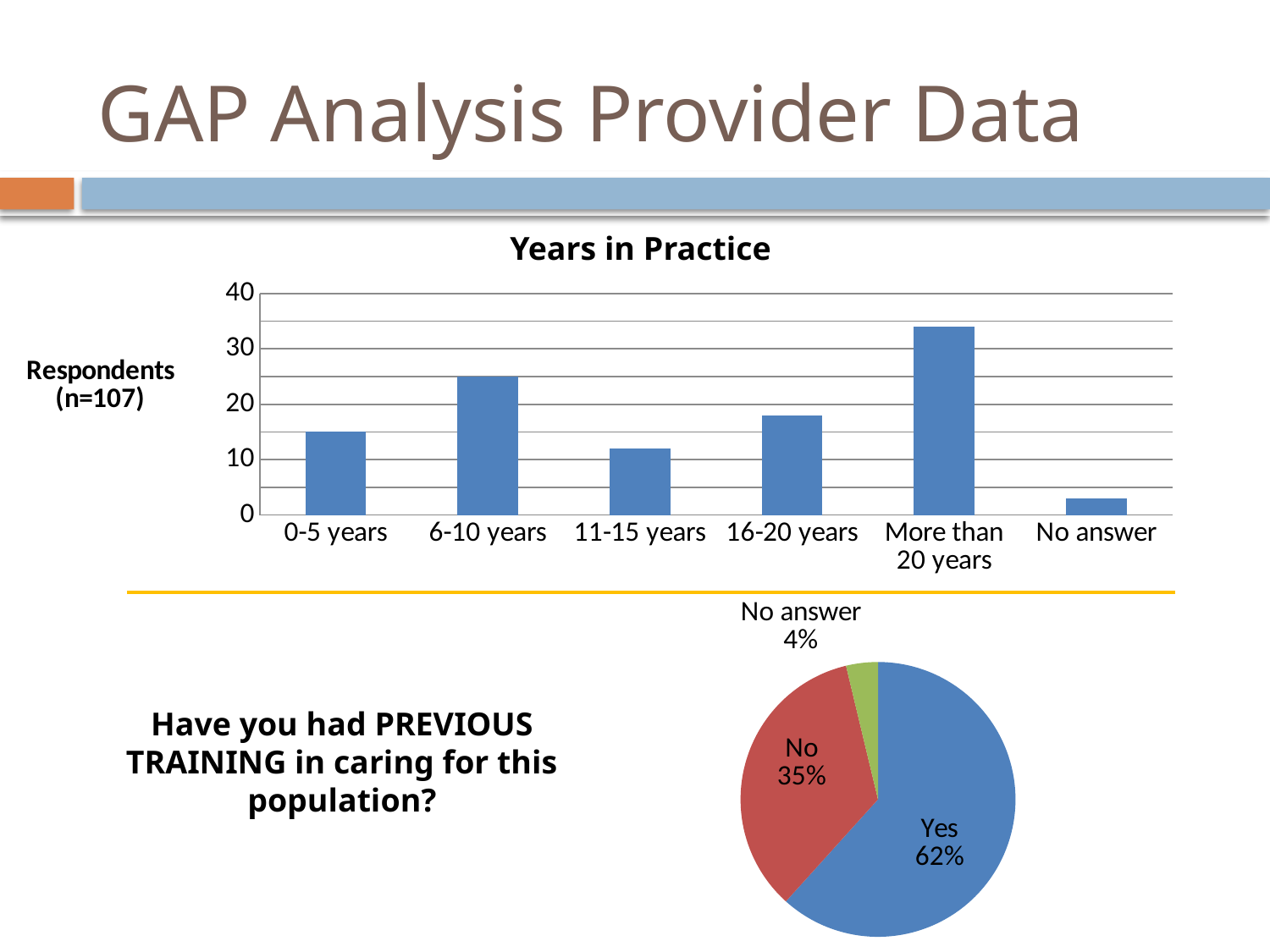
How many slices does the pie chart about previous training have? 3 In the Years in Practice chart, which has more respondents, 6-10 years or 16-20 years? 6-10 years In the Years in Practice chart, is the value for More than 20 years greater or less than 30? greater In the Years in Practice chart, which category has the lowest number of respondents? No answer What kind of chart is the Years in Practice chart? bar chart In the Years in Practice chart, which category has the highest number of respondents? More than 20 years In the Years in Practice chart, is the value for 16-20 years greater or less than 20? less How many categories are shown on the x axis of the Years in Practice chart? 6 In the pie chart about previous training, what percentage of respondents answered Yes? 62% In the pie chart about previous training, what is the difference between the Yes and No shares? 27% In the Years in Practice chart, is the value for No answer greater or less than 10? less